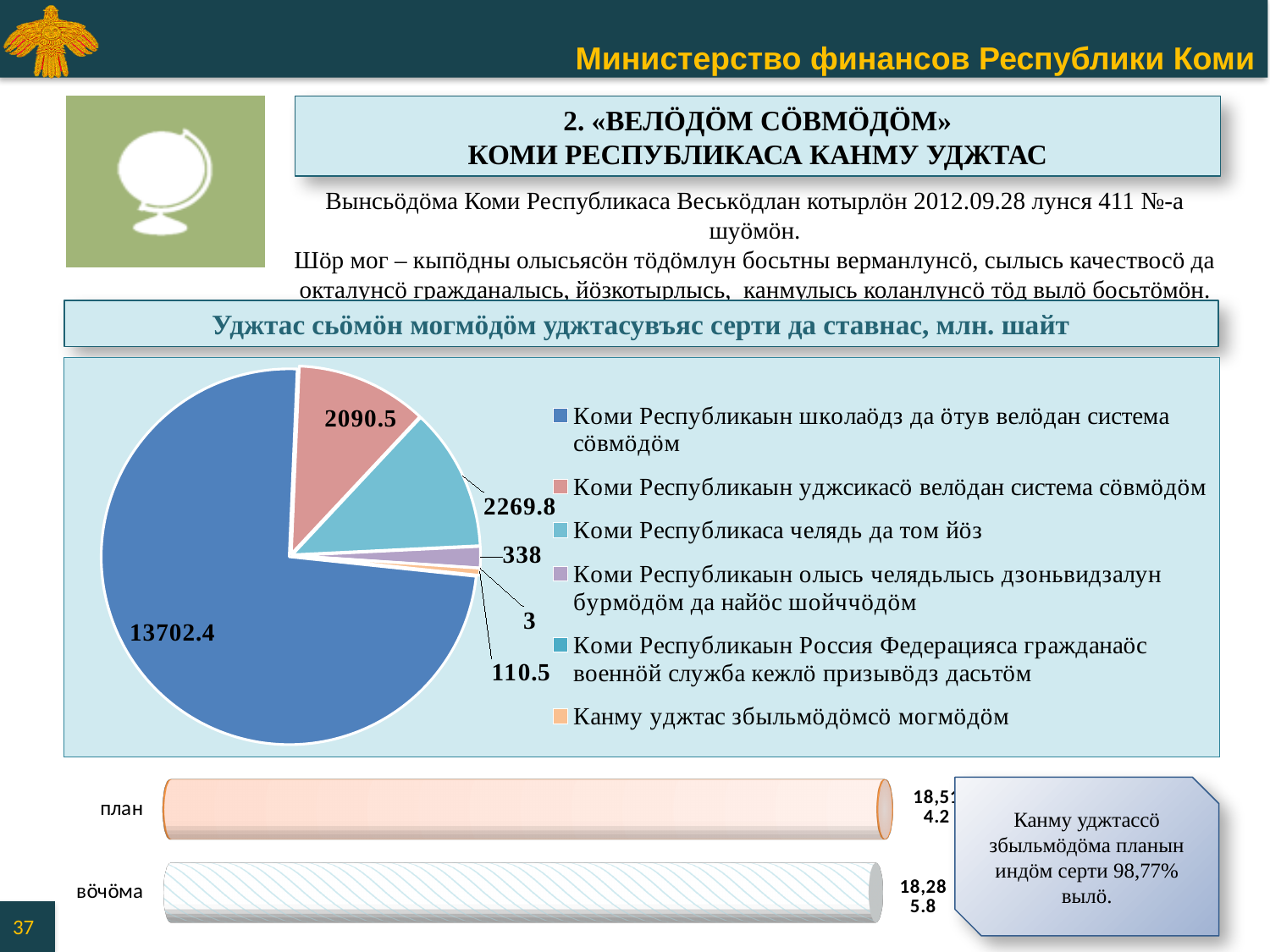
How many bars does the lower chart show? 2 What is the smallest value shown on the pie chart? 3 How many entries does the legend of the pie chart list? 6 In the pie chart, what is the value for «Коми Республикаса челядь да том йöз»? 2269.8 In the pie chart, what is the value for «Коми Республикаын школаöдз да öтув велöдан система сöвмöдöм»? 13702.4 In the pie chart, what is the value for «Коми Республикаын олысь челядьлысь дзоньвидзалун бурмöдöм да найöс шойччöдöм»? 338 In the pie chart, which is larger: the value for «Коми Республикаса челядь да том йöз» or for «Коми Республикаын уджсикасö велöдан система сöвмöдöм»? Коми Республикаса челядь да том йöз What is the difference between the values 2269.8 and 2090.5 in the pie chart? 179.3 What type of chart is the upper chart on the slide? pie chart In the pie chart, what is the value for «Коми Республикаын уджсикасö велöдан система сöвмöдöм»? 2090.5 What type of chart is the lower chart with the categories «план» and «вöчöма»? bar chart Which category has the largest slice in the pie chart? Коми Республикаын школаöдз да öтув велöдан система сöвмöдöм